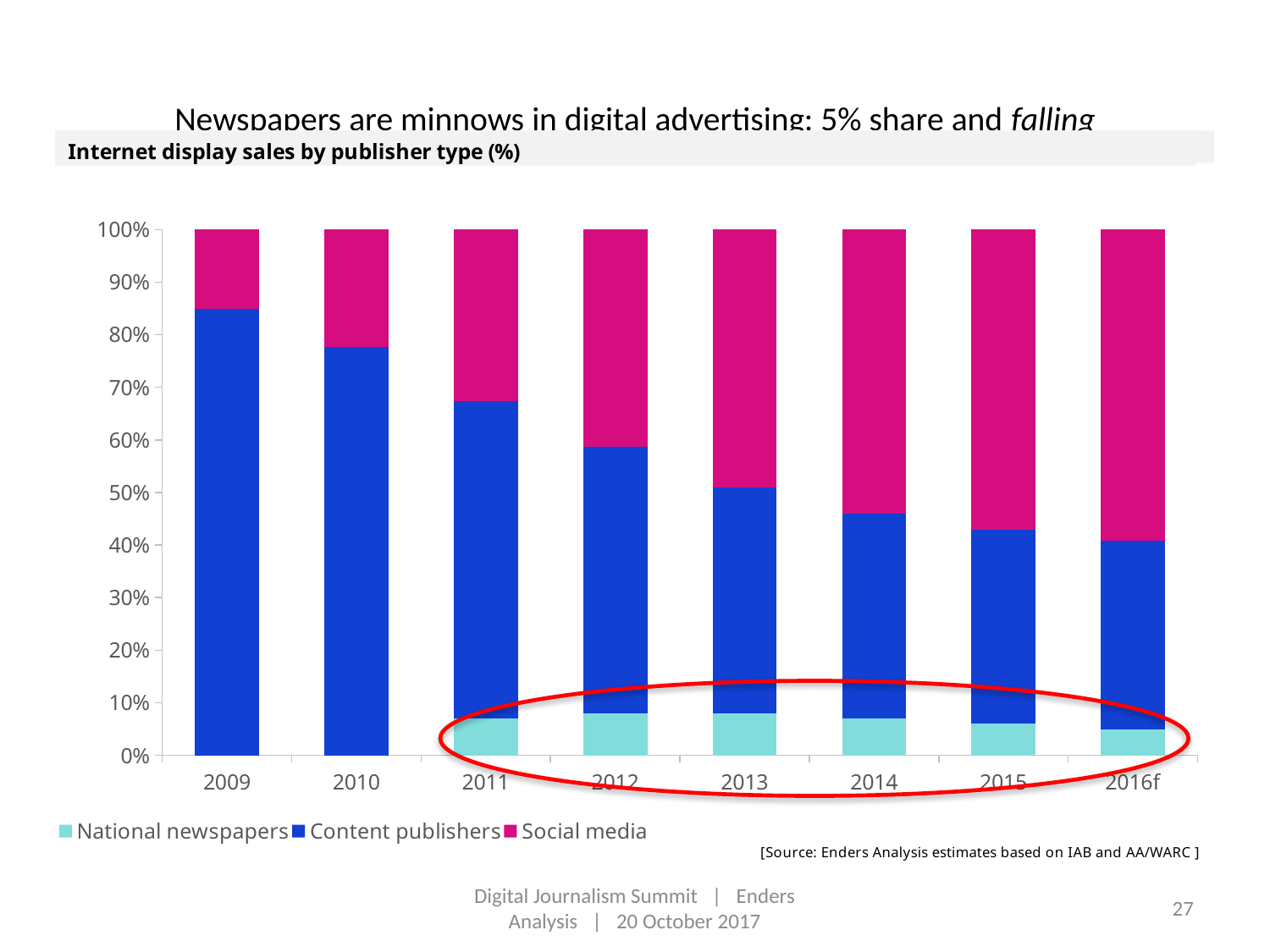
What is the total height of each stacked bar? 100% How many series does the legend list? 3 Does the Social media share rise or fall from 2009 to 2016f? Rise In which year is the Content publishers share the highest? 2009 How many years (categories) are shown on the x axis? 8 Does the Content publishers share rise or fall from 2009 to 2016f? Fall Is the Social media share in 2016f greater or less than 50%? greater What kind of chart is shown on the slide? Stacked bar chart In which year is the Social media share the highest? 2016f Is the Social media share in 2009 greater or less than 20%? less What are the three series listed in the legend? National newspapers, Content publishers, Social media What is the title of the chart? Internet display sales by publisher type (%)